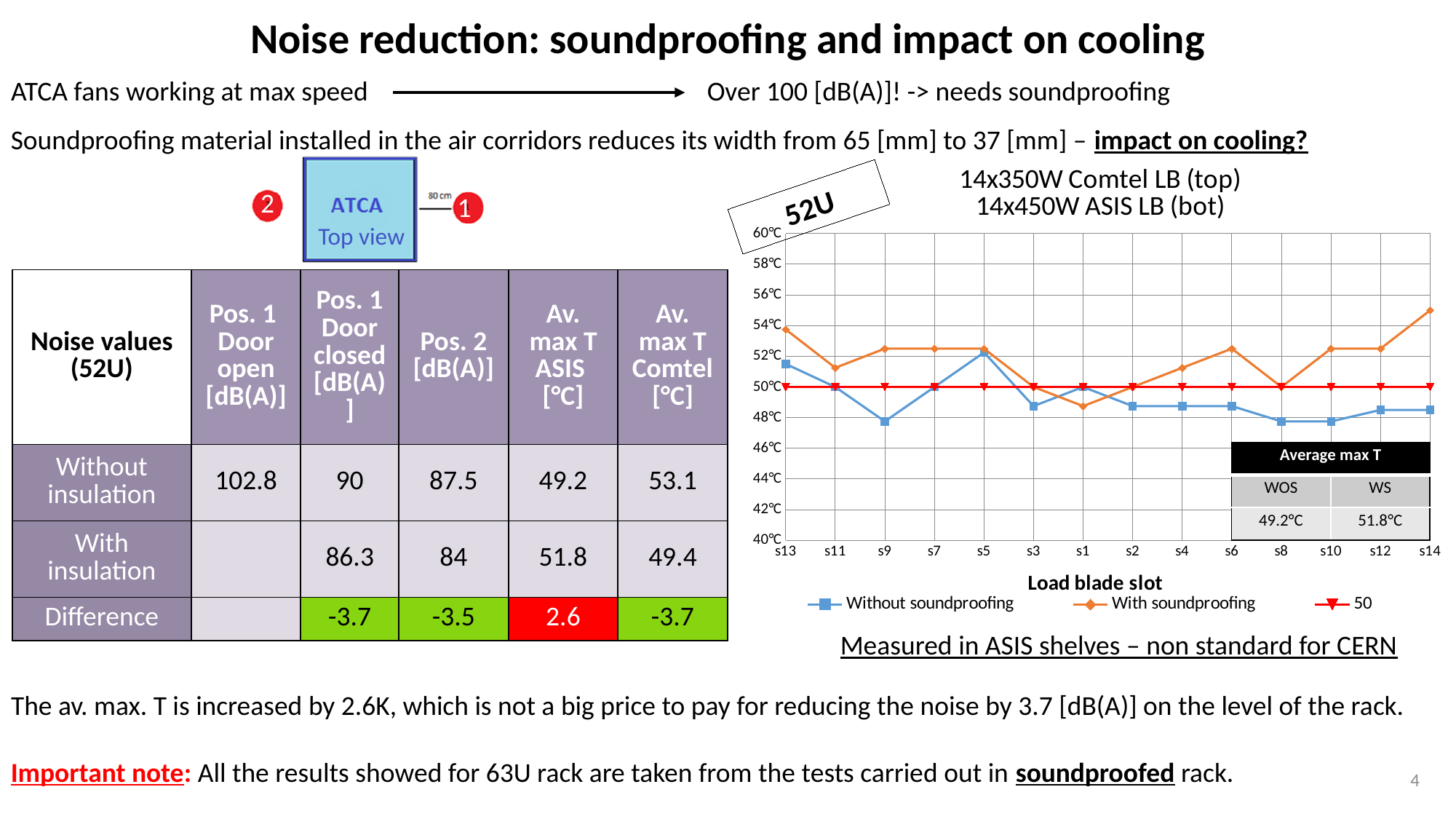
At which load blade slot does the With soundproofing series reach its highest value? s14 How many series does the chart legend list? 3 By how much does the WS average max T exceed the WOS average max T in the chart's inset table? 2.6°C How many load blade slots are plotted along the x axis of the chart? 14 At which load blade slot does the With soundproofing series reach its lowest value? s1 Is the Without soundproofing value at slot s9 greater or less than 50°C? less What is the x-axis title of the chart? Load blade slot According to the Average max T inset on the chart, what is the average max T for WS? 51.8°C At slot s9, which series has the higher value: Without soundproofing or With soundproofing? With soundproofing Is the With soundproofing value at slot s14 greater or less than 54°C? greater According to the Average max T inset on the chart, what is the average max T for WOS? 49.2°C What kind of chart is shown on the slide? line chart